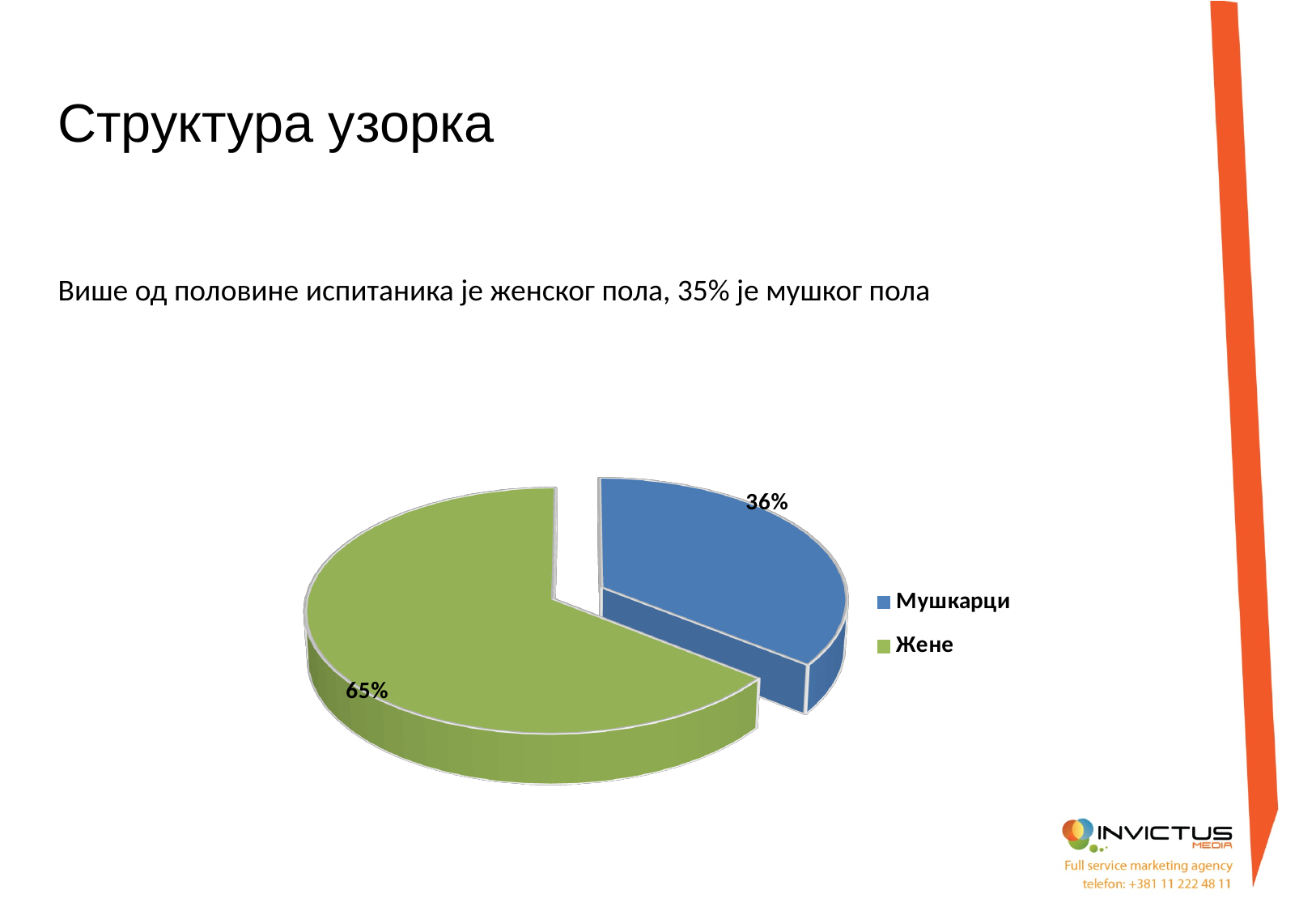
What kind of chart is shown on the slide? pie chart How many entries does the legend list? 2 What colour is the Мушкарци slice? blue What is the difference in percentage points between the Жене slice and the Мушкарци slice? 29 Which category has the smallest slice of the pie? Мушкарци Which slice is larger, Мушкарци or Жене? Жене What percentage of the pie is labelled for Жене? 65% What percentage of the pie is labelled for Мушкарци? 36% What share of the pie does the Жене slice represent? 65% What is the title of the slide containing the chart? Структура узорка Which category has the largest slice of the pie? Жене How many slices does the pie chart have? 2